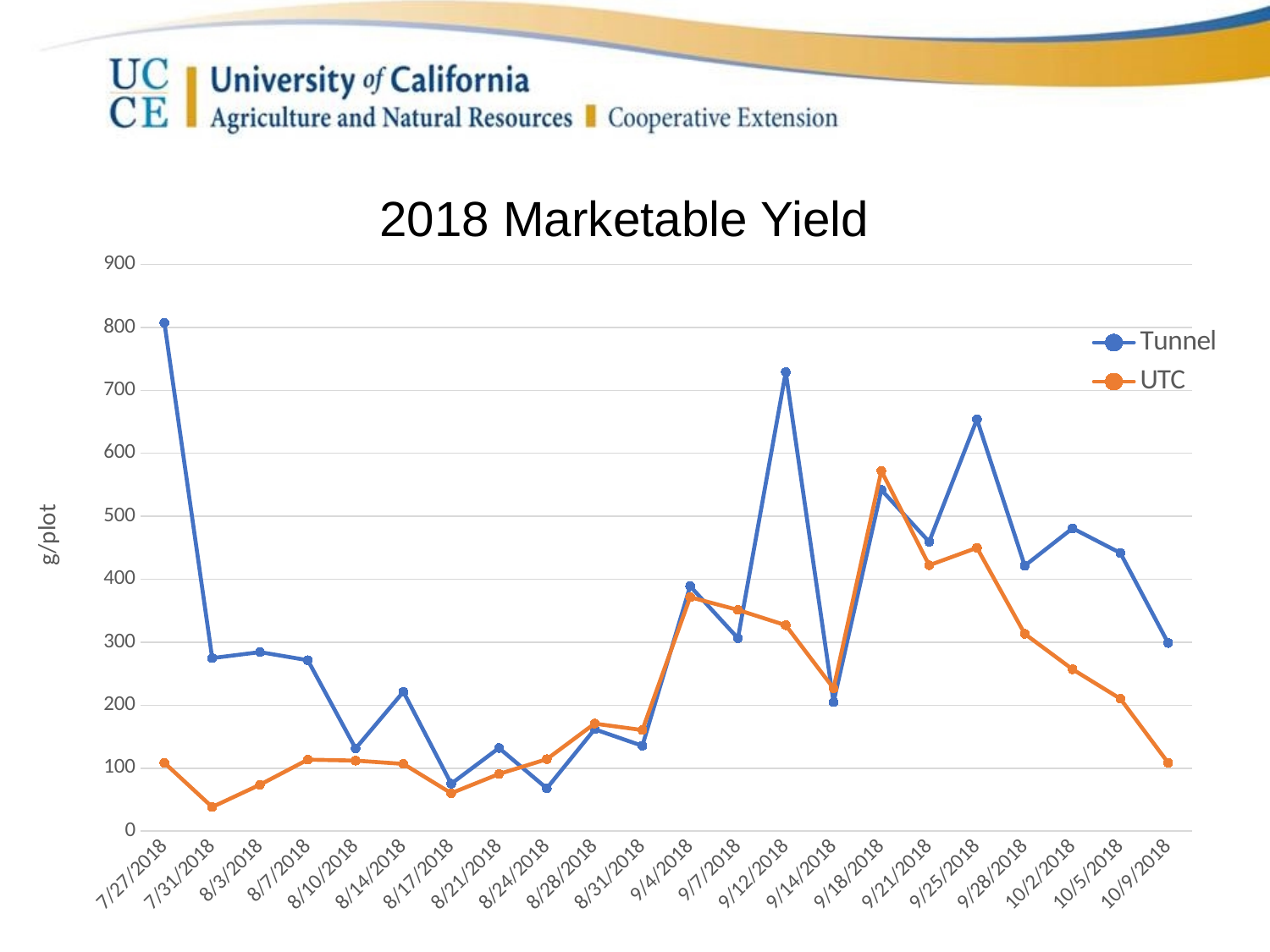
Does the UTC series rise or fall from 9/25/2018 to 10/9/2018? fall On 9/12/2018, which series has the larger value, Tunnel or UTC? Tunnel On which date does the UTC series reach its highest value? 9/18/2018 Is the UTC value on 10/9/2018 greater or less than 200? less How many series does the legend list? 2 On which date does the UTC series reach its lowest value? 7/31/2018 On which date does the Tunnel series reach its highest value? 7/27/2018 What kind of chart is shown on the slide? line chart What is the label on the y axis? g/plot What is the title of the chart? 2018 Marketable Yield Is the Tunnel value on 7/27/2018 greater or less than 700? greater How many dates are plotted along the x axis? 22